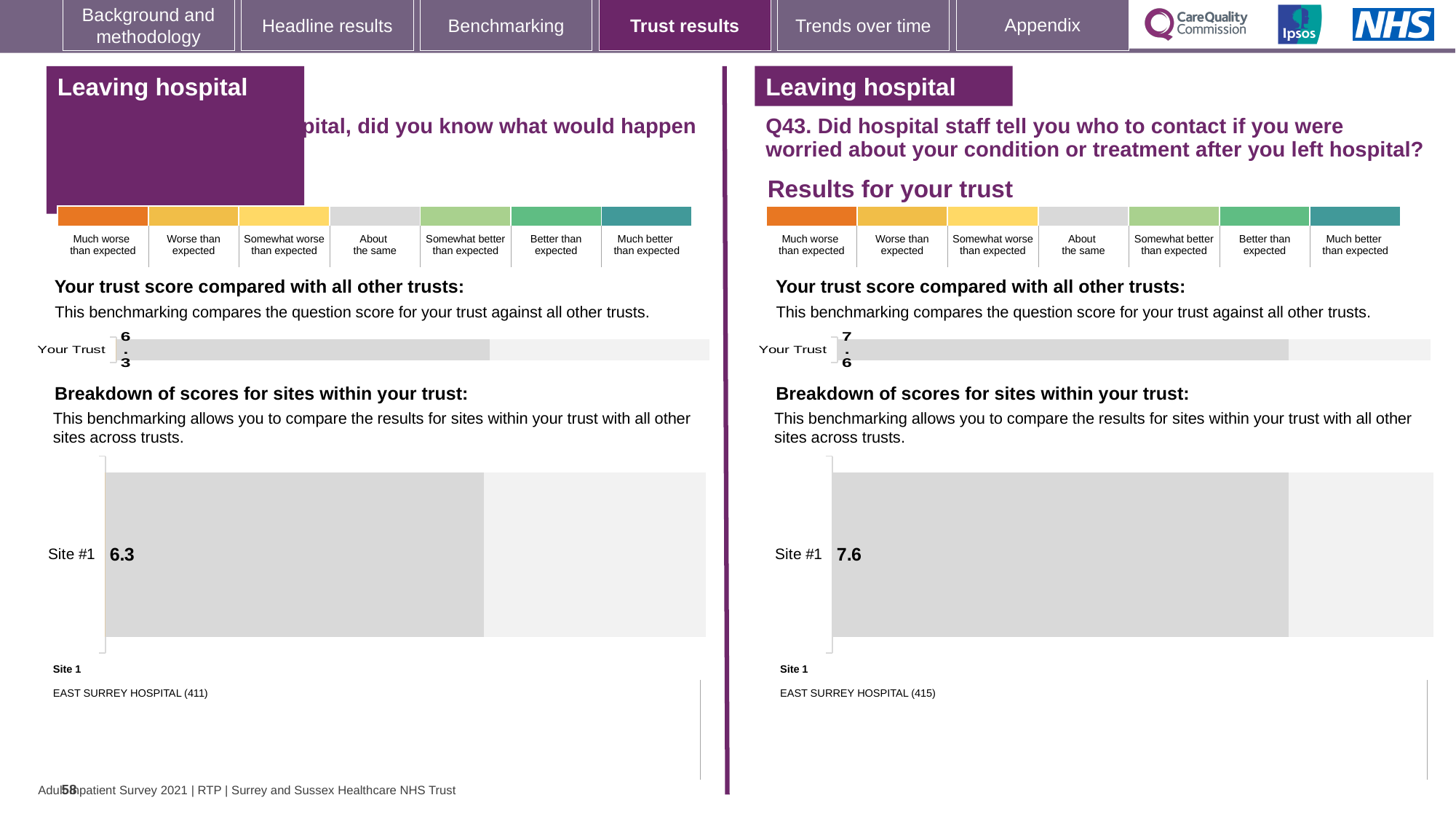
On the right half of the slide (Q43), what is the score shown for Your Trust in the trust score bar chart? 7.6 In the right-hand site breakdown chart for Q43, what is the score for Site #1? 7.6 What type of chart is used to show the Site #1 score on the right half of the slide? Bar chart How many sites are shown in the right-hand site breakdown chart for Q43? 1 Which hospital is listed as Site 1 beneath the left-hand site breakdown chart? EAST SURREY HOSPITAL (411) In the left-hand site breakdown chart, what is the score for Site #1? 6.3 Which hospital is listed as Site 1 beneath the right-hand site breakdown chart? EAST SURREY HOSPITAL (415) Which is larger: the Site #1 score in the left-hand site breakdown chart or the Site #1 score in the right-hand site breakdown chart? The right-hand chart (7.6) What is the difference between the Site #1 score in the right-hand site breakdown chart and the Site #1 score in the left-hand site breakdown chart? 1.3 On the left half of the slide, what is the score shown for Your Trust in the trust score bar chart? 6.3 Is the Your Trust score in the right-hand trust score chart for Q43 greater or less than 7? greater How many sites are shown in the left-hand site breakdown chart? 1